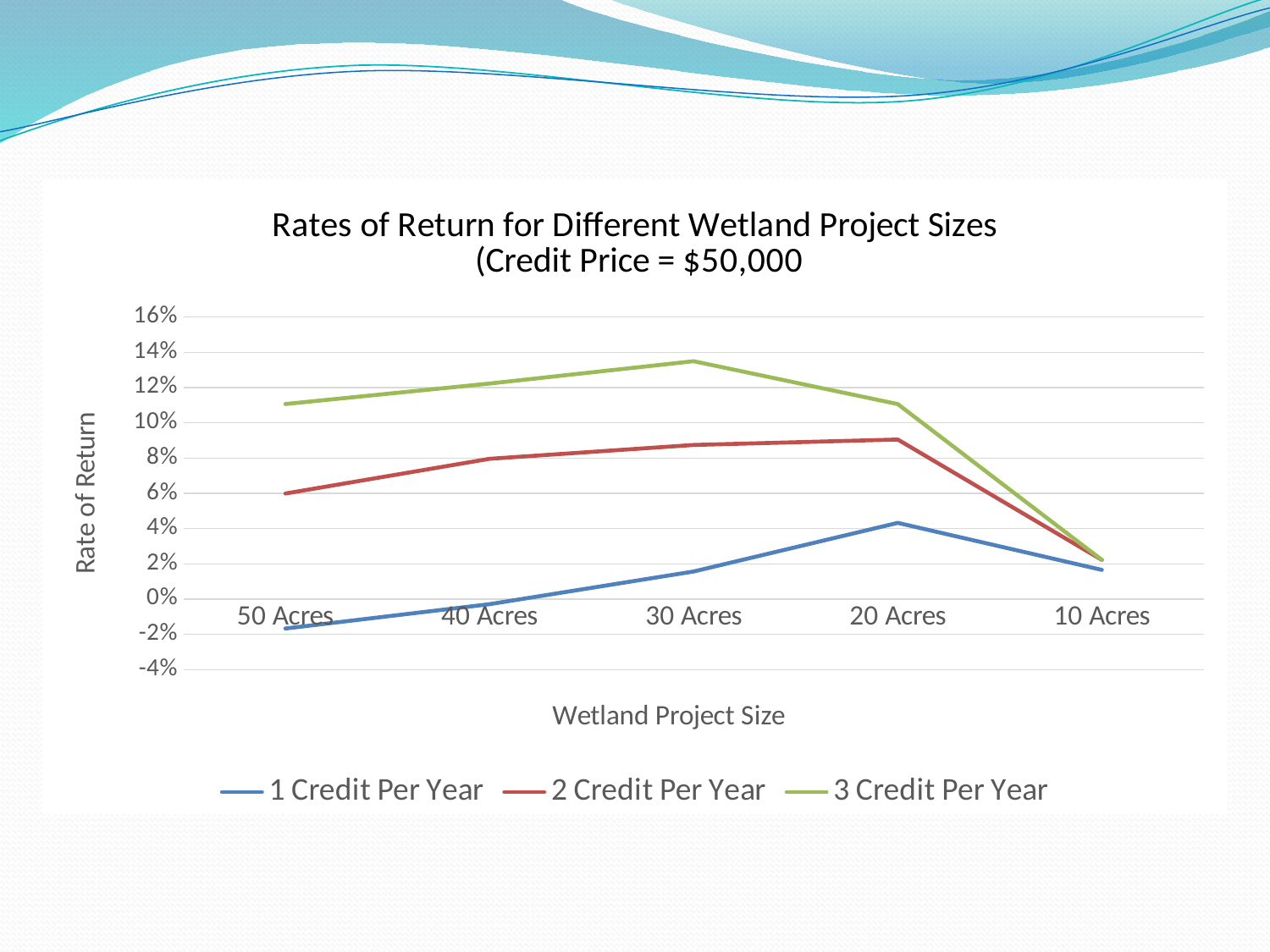
Is the value for 3 Credit Per Year at 10 Acres greater or less than 4%? less Is the value for 2 Credit Per Year at 20 Acres greater or less than 8%? greater How many wetland project sizes are shown on the x axis? 5 Does the 1 Credit Per Year series rise or fall from 50 Acres to 20 Acres? rise Is the value for 3 Credit Per Year at 30 Acres greater or less than 12%? greater At which project size does the 3 Credit Per Year series reach its highest rate of return? 30 Acres What kind of chart is shown on the slide? Line chart At which project size is the 1 Credit Per Year rate of return lowest? 50 Acres At which project size does the 1 Credit Per Year series reach its highest rate of return? 20 Acres At 40 Acres, which series has the higher rate of return: 1 Credit Per Year or 3 Credit Per Year? 3 Credit Per Year How many series does the legend list? 3